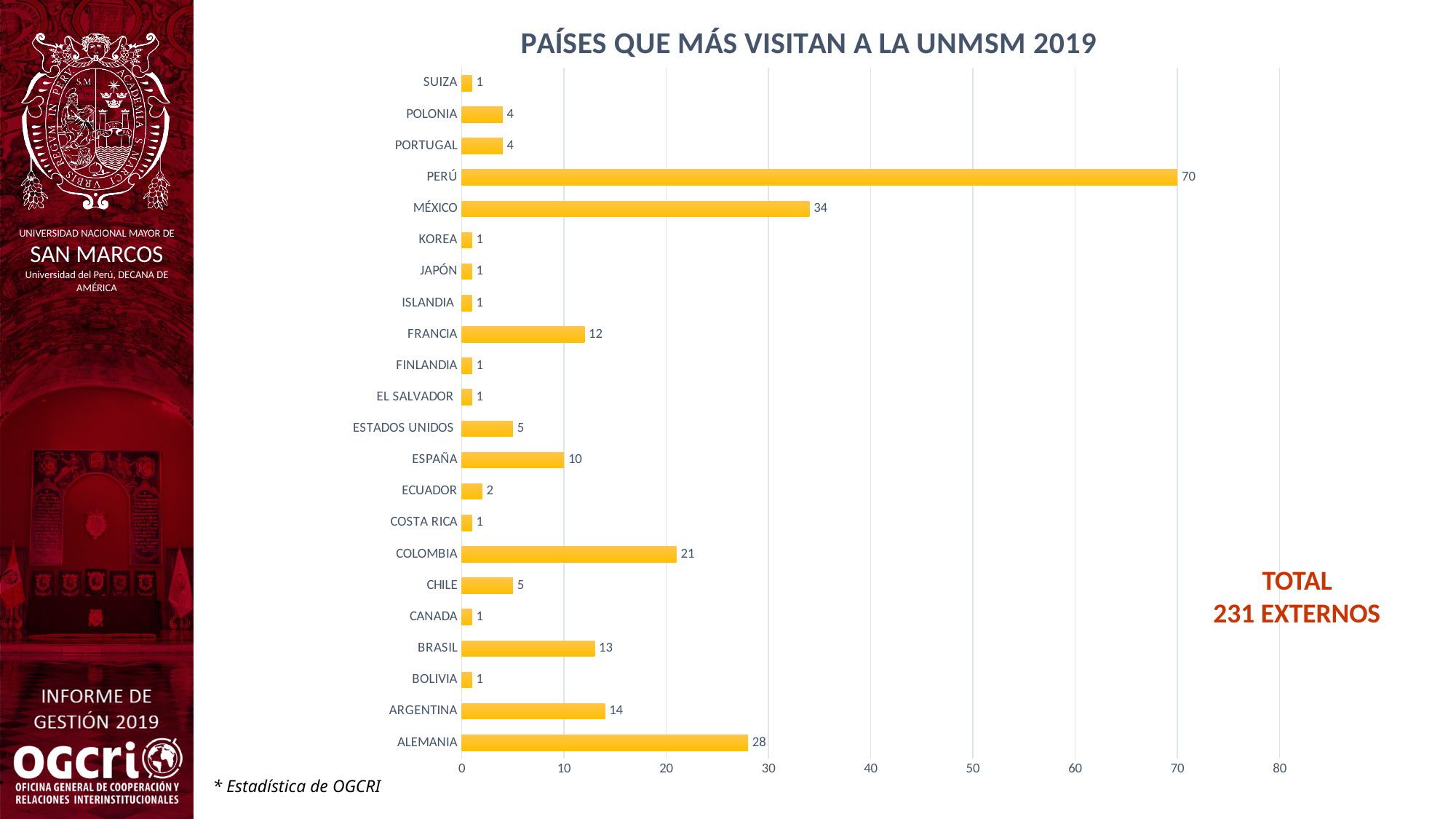
Which is larger, the value for BRASIL or the value for FRANCIA? BRASIL How many countries are shown in the chart? 22 What is the value for COLOMBIA? 21 Is the value for COLOMBIA greater or less than 20? greater Which country has the highest value? PERÚ What is the value for MÉXICO? 34 What is the difference between the values for PERÚ and MÉXICO? 36 What is the value for PERÚ? 70 What is the title of the chart? PAÍSES QUE MÁS VISITAN A LA UNMSM 2019 What kind of chart is shown on the slide? bar chart What is the value for ALEMANIA? 28 What is the difference between the values for ALEMANIA and ARGENTINA? 14